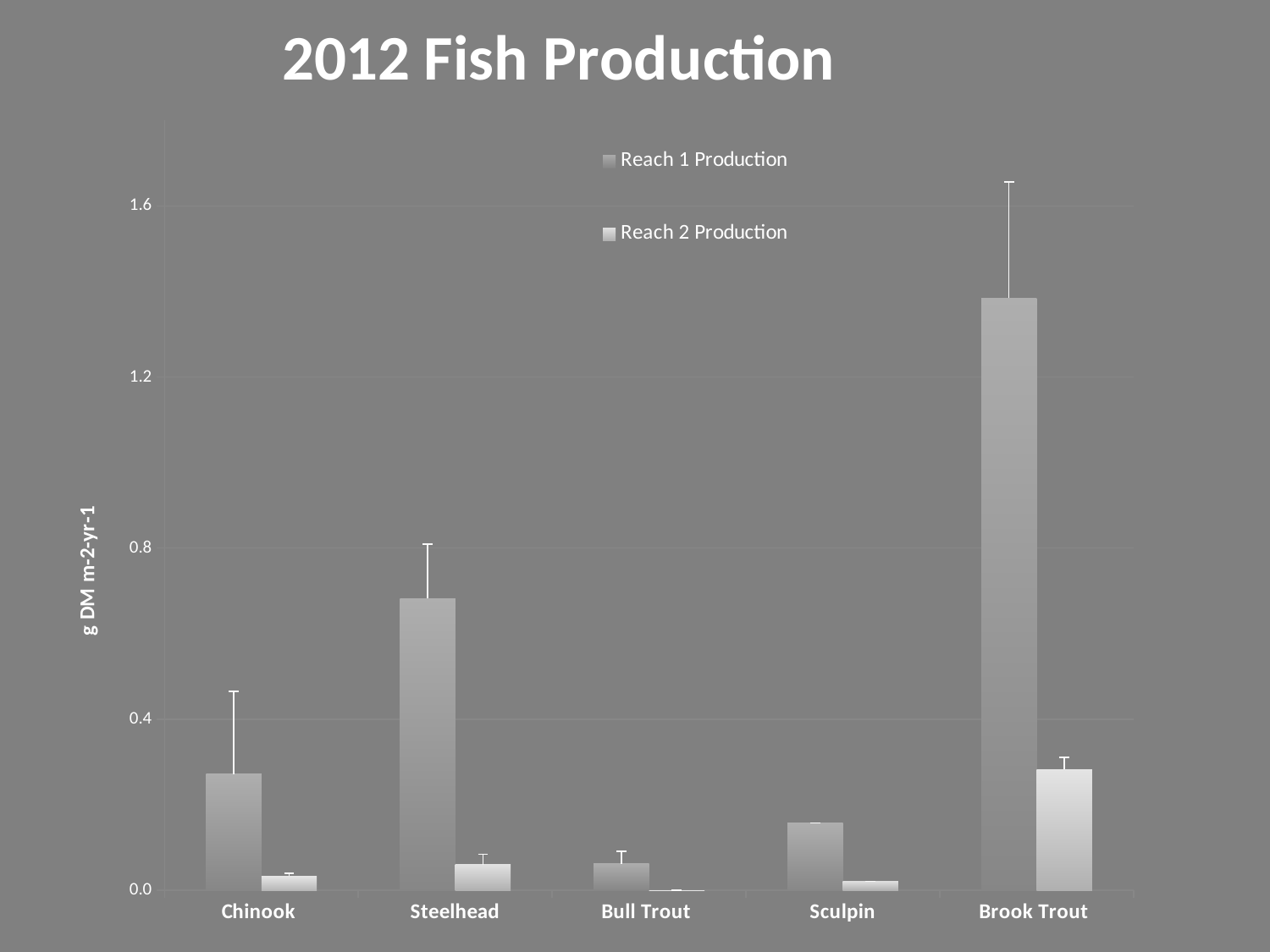
Is the Reach 1 Production value for Steelhead greater or less than 0.8? less Which species has the highest Reach 1 Production? Brook Trout What is the title of the chart? 2012 Fish Production What type of chart is shown on the slide? bar chart How many fish species categories are shown on the x axis? 5 Which species has the highest Reach 2 Production? Brook Trout Which species has the lowest Reach 1 Production? Bull Trout Is the Reach 1 Production value for Chinook greater or less than 0.4? less Which is larger for Steelhead: Reach 1 Production or Reach 2 Production? Reach 1 Production How many series does the legend list? 2 Is the Reach 1 Production value for Brook Trout greater or less than 1.2? greater What is the label on the y axis? g DM m-2-yr-1